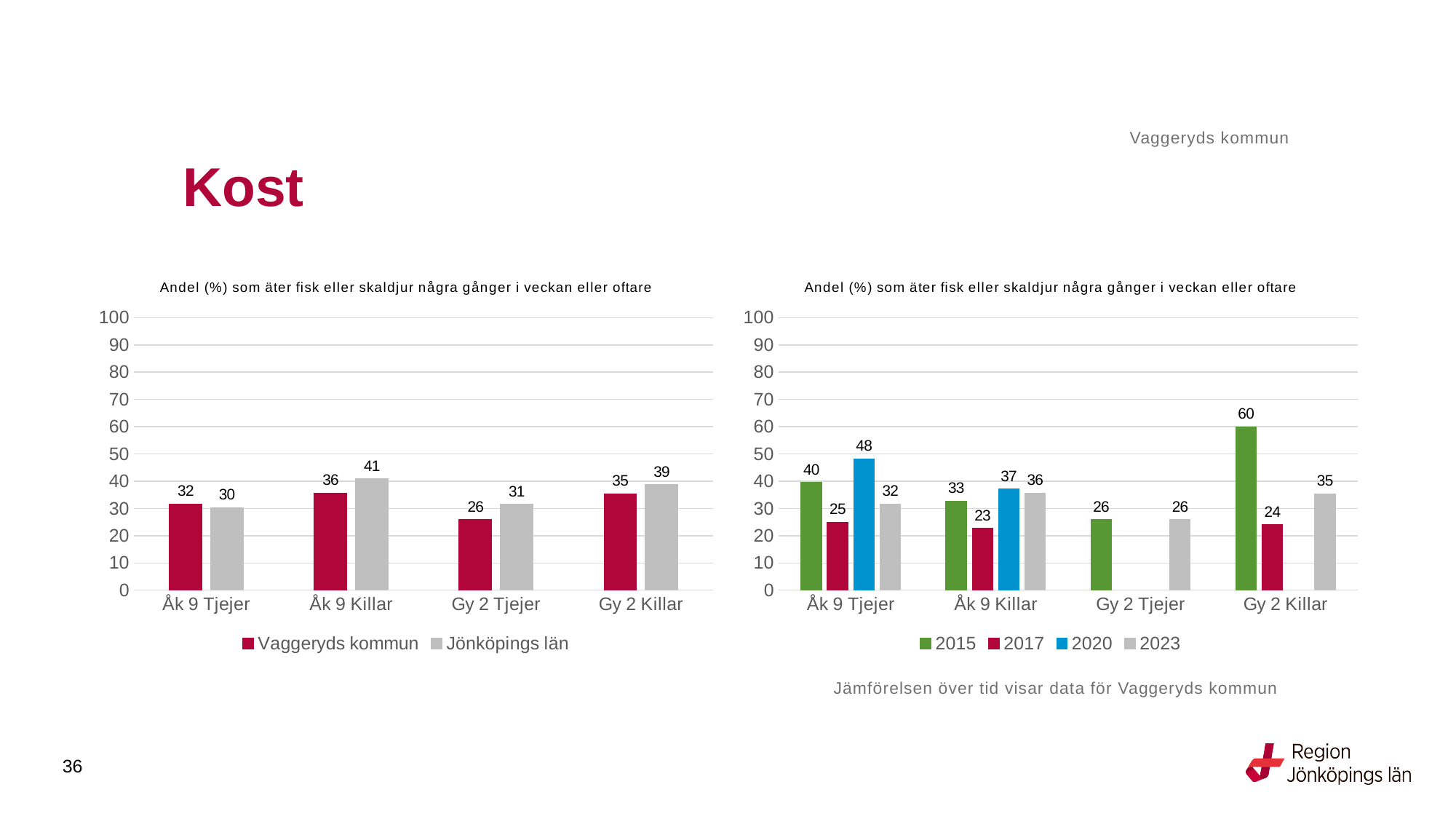
In the left chart, what is the value for Vaggeryds kommun for Åk 9 Killar? 36 In the right chart, which category has the highest value for 2015? Gy 2 Killar In the right chart, what is the difference between the 2015 and 2017 values for Gy 2 Killar? 36 In the left chart, which is larger for Åk 9 Tjejer: Vaggeryds kommun or Jönköpings län? Vaggeryds kommun What kind of chart is the left chart? Bar chart In the left chart, what is the value for Jönköpings län for Gy 2 Tjejer? 31 In the left chart, which category has the lowest value for Vaggeryds kommun? Gy 2 Tjejer In the right chart, what is the value for 2020 for Åk 9 Tjejer? 48 In the right chart, which colour represents 2020 in the legend? Blue In the right chart, how many series does the legend list? 4 In the left chart, what is the difference between Jönköpings län and Vaggeryds kommun for Åk 9 Killar? 5 In the right chart, how many categories are shown on the x axis? 4